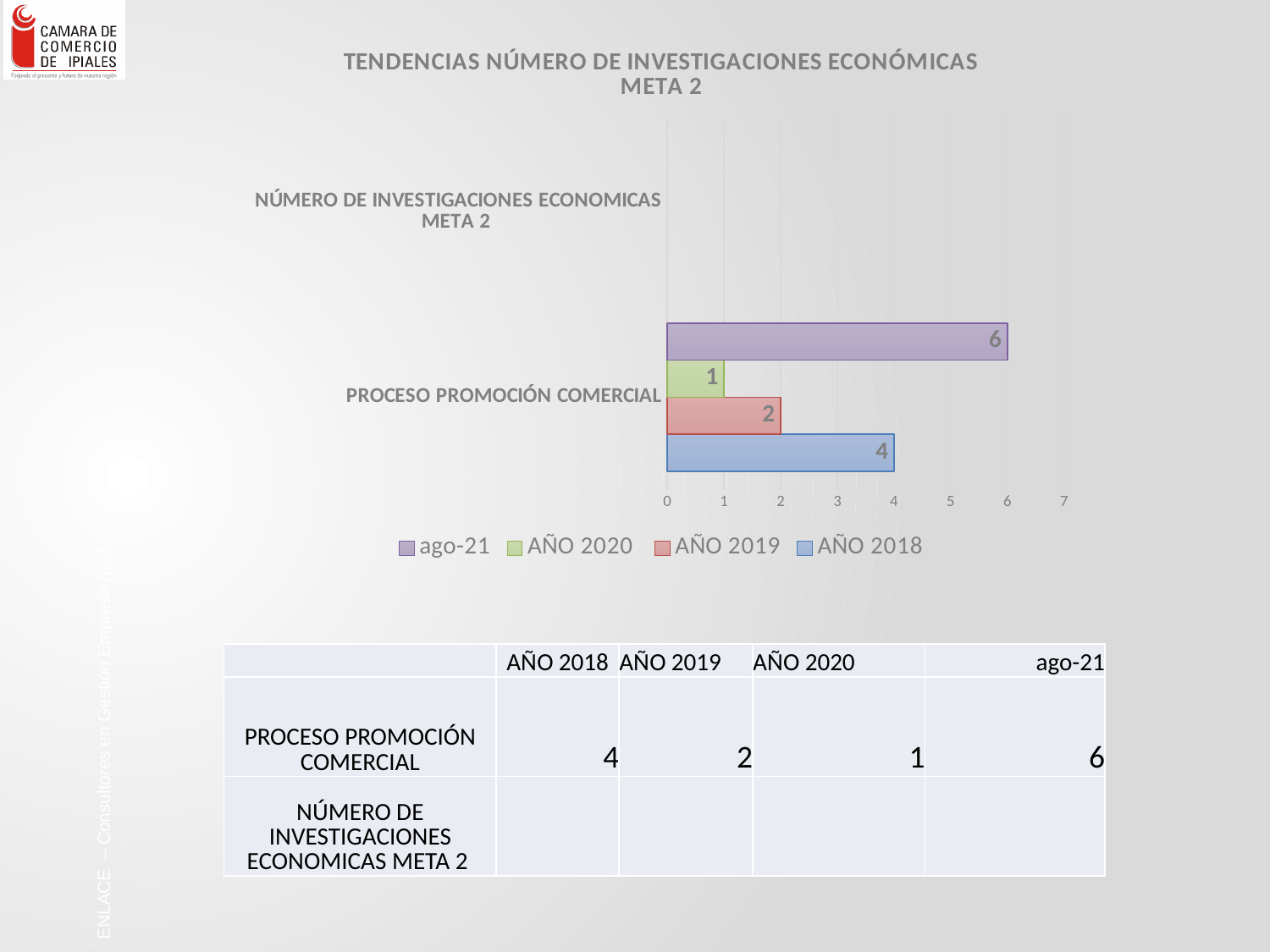
What is the value for AÑO 2019 for PROCESO PROMOCIÓN COMERCIAL? 2 Which series has the lowest value for PROCESO PROMOCIÓN COMERCIAL? AÑO 2020 What is the value for AÑO 2018 for PROCESO PROMOCIÓN COMERCIAL? 4 What is the value for ago-21 for PROCESO PROMOCIÓN COMERCIAL? 6 What is the difference between the ago-21 value and the AÑO 2018 value for PROCESO PROMOCIÓN COMERCIAL? 2 What is the title of the chart? TENDENCIAS NÚMERO DE INVESTIGACIONES ECONÓMICAS META 2 What kind of chart is shown on the slide? bar chart Which series has the highest value for PROCESO PROMOCIÓN COMERCIAL? ago-21 How many series does the legend list? 4 Which is larger for PROCESO PROMOCIÓN COMERCIAL, AÑO 2019 or AÑO 2020? AÑO 2019 What is the highest value shown on the horizontal axis? 7 What is the value for AÑO 2020 for PROCESO PROMOCIÓN COMERCIAL? 1